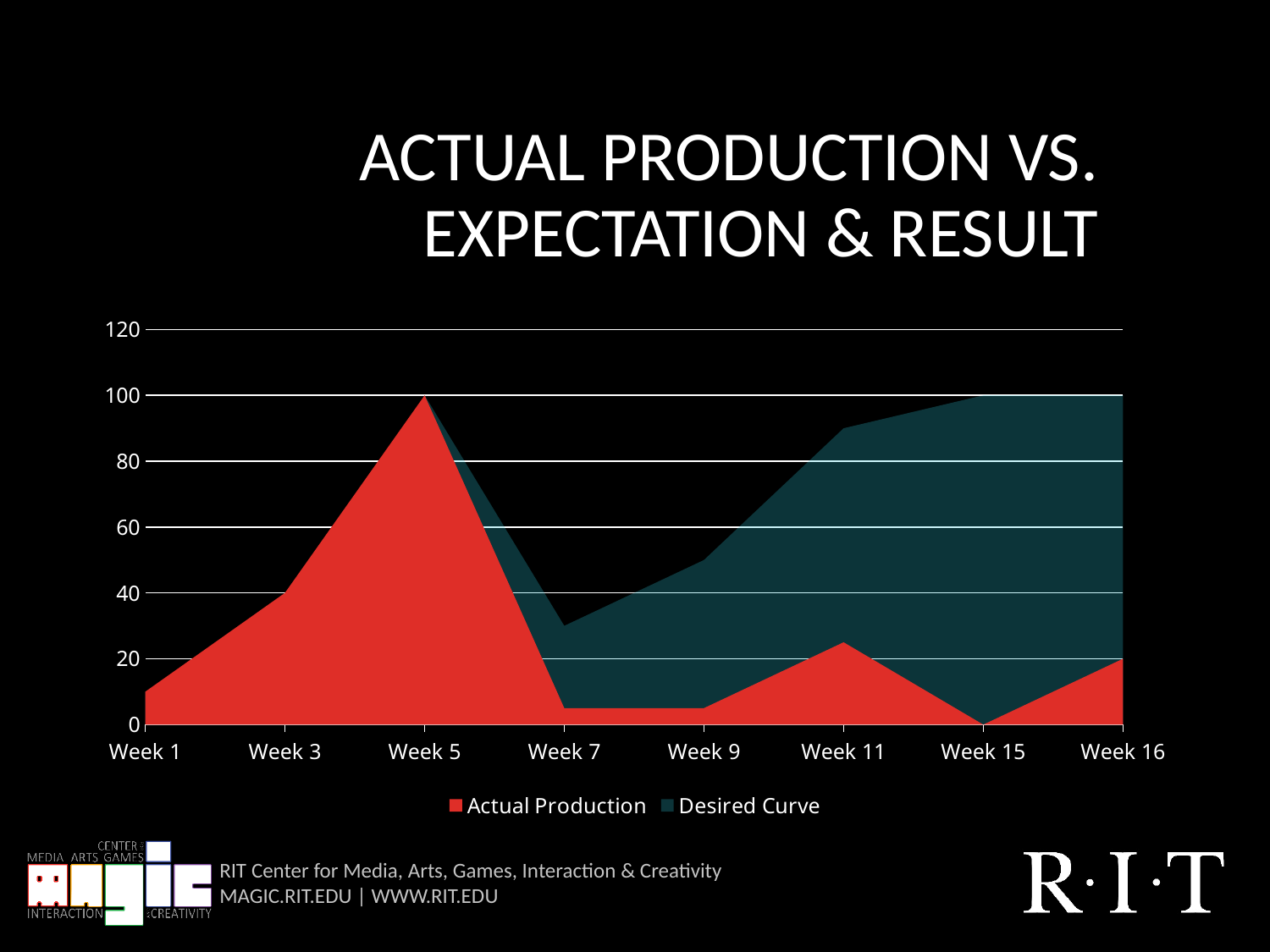
What kind of chart is shown on the slide? Area chart How many series does the legend list? 2 Does the Desired Curve rise or fall from Week 7 to Week 16? Rises How many weeks are shown on the x axis? 8 What is the Actual Production value at Week 5? 100 At which week does Actual Production reach its highest value? Week 5 Is the Desired Curve value at Week 11 greater or less than 80? greater At Week 11, which is larger: Actual Production or Desired Curve? Desired Curve Is the Actual Production value at Week 7 greater or less than 20? less At which week is Actual Production at its lowest? Week 15 What is the Actual Production value at Week 15? 0 What is the Desired Curve value at Week 16? 100